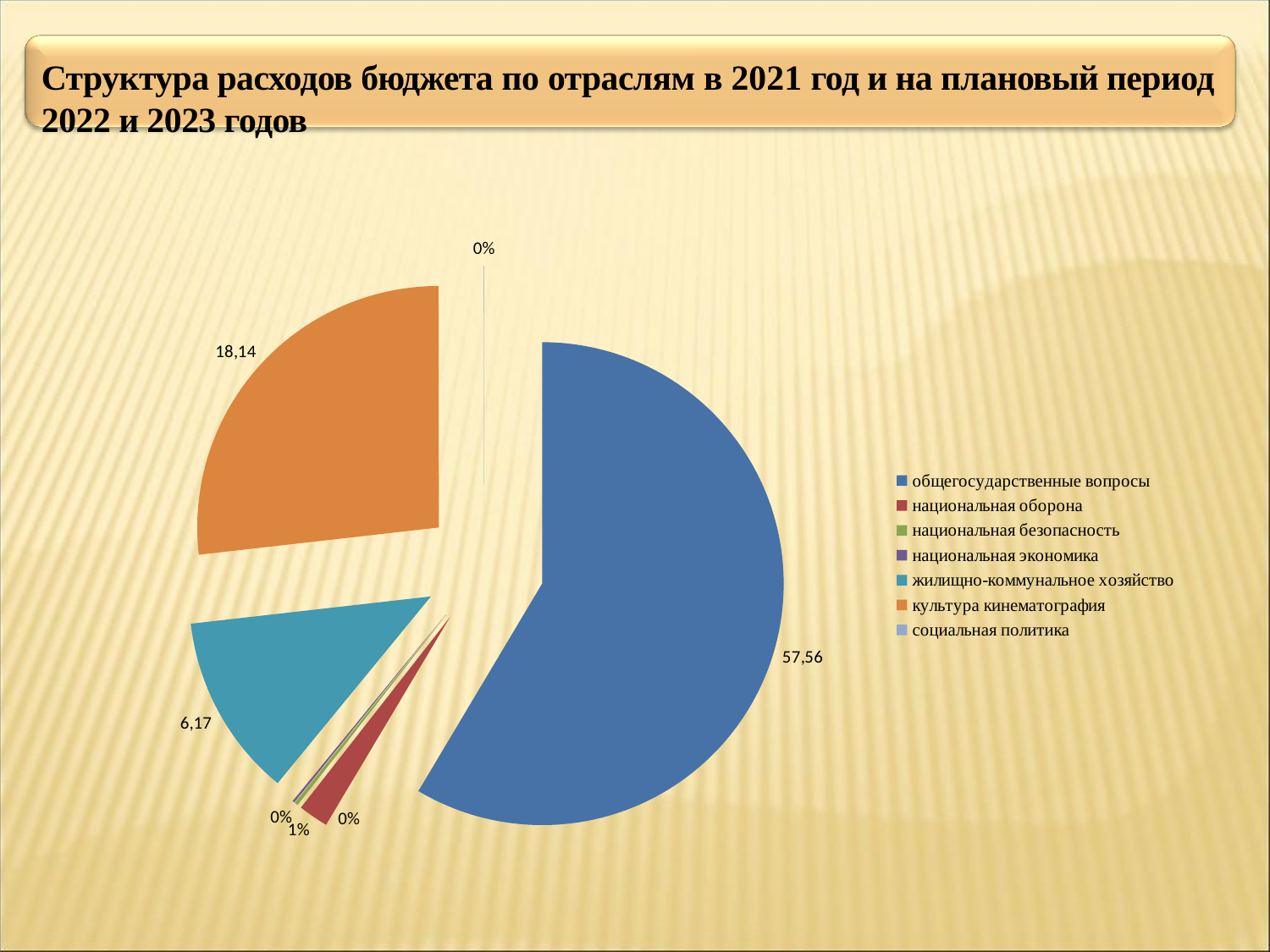
How many categories does the legend of the pie chart list? 7 What value is labelled on the slice for культура кинематография? 18,14 What colour is the slice for общегосударственные вопросы? blue Which category has the largest slice of the pie chart? общегосударственные вопросы What value is labelled on the slice for жилищно-коммунальное хозяйство? 6,17 What is the difference between the labelled values for культура кинематография and жилищно-коммунальное хозяйство? 11,97 Which slice is larger: культура кинематография or жилищно-коммунальное хозяйство? культура кинематография Which category is shown in orange in the legend? культура кинематография What kind of chart is shown on the slide? pie chart What value is labelled on the slice for общегосударственные вопросы? 57,56 What is the difference between the labelled values for общегосударственные вопросы and культура кинематография? 39,42